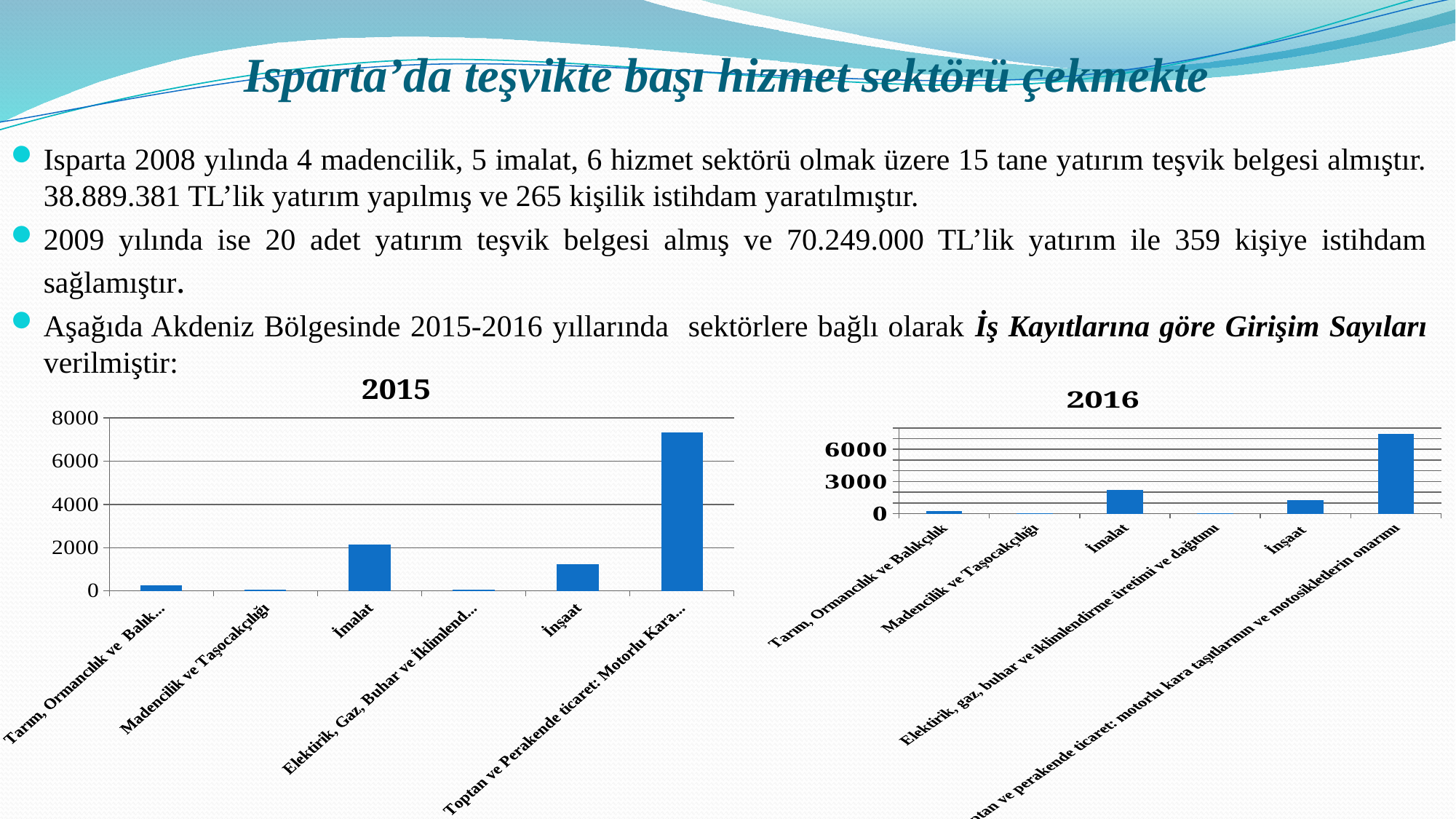
How many categories are shown on the 2016 chart? 6 In the 2016 chart, is the value for İmalat greater or less than 3000? less In the 2015 chart, which category has the highest value? Toptan ve Perakende ticaret: Motorlu Kara... What is the title of the chart on the right side of the slide? 2016 In the 2016 chart, which category has the highest value? Toptan ve perakende ticaret: motorlu kara taşıtlarının ve motosikletlerin onarımı What kind of chart is the 2015 chart? bar chart In the 2015 chart, is the value for Toptan ve Perakende ticaret greater or less than 6000? greater How many categories are shown on the 2015 chart? 6 In the 2015 chart, is the value for İnşaat greater or less than 2000? less In the 2015 chart, which is larger, the value for İmalat or the value for İnşaat? İmalat